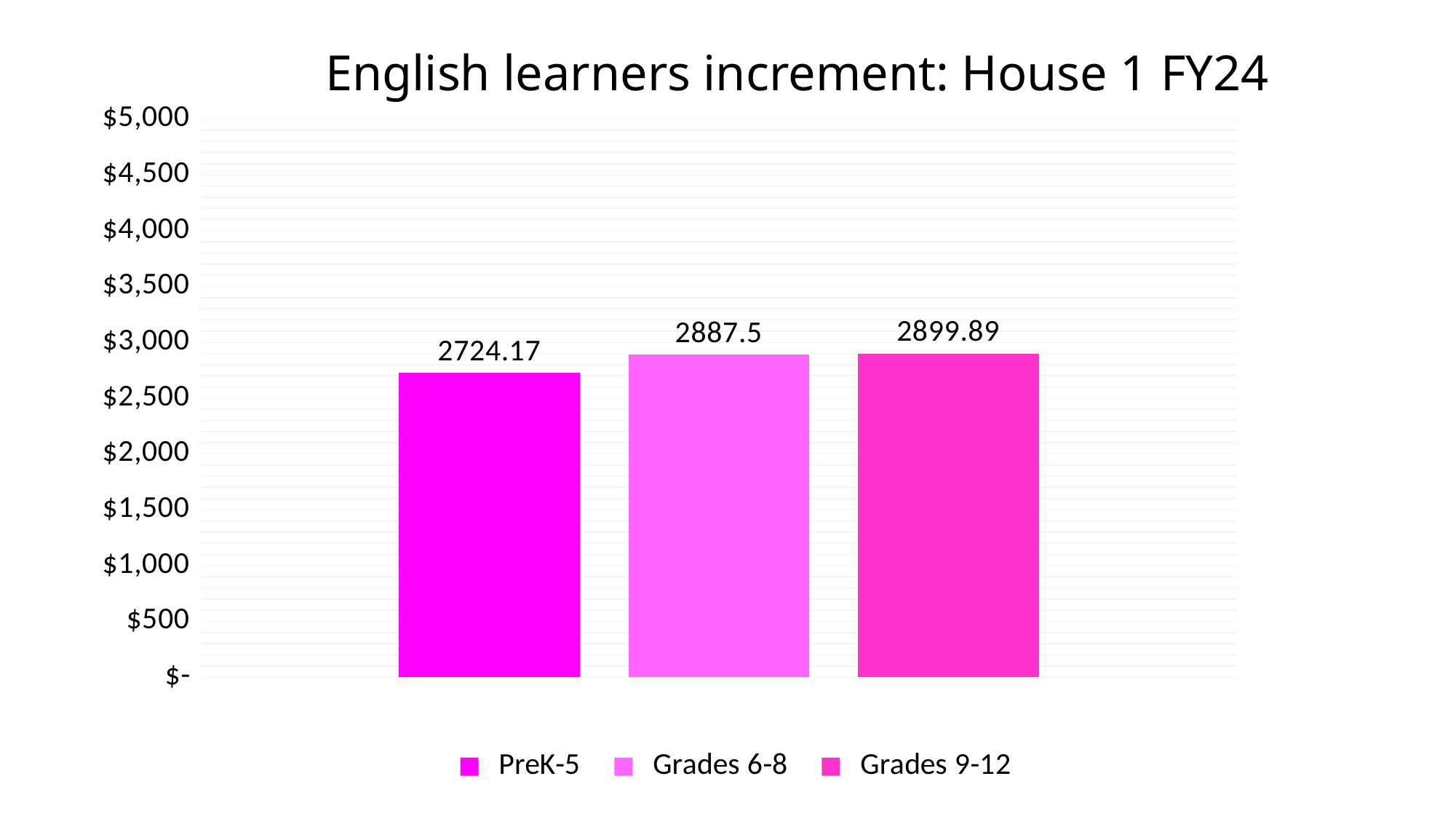
What is the difference between the values for Grades 6-8 and PreK-5? 163.33 How many bars are shown in the chart? 3 Which grade band has the lowest value? PreK-5 Which grade band has the highest value? Grades 9-12 What is the value for Grades 9-12? 2899.89 Which is larger, the value for PreK-5 or the value for Grades 6-8? Grades 6-8 What kind of chart is shown on the slide? bar chart What is the value for PreK-5? 2724.17 Is the value for PreK-5 greater or less than $3,000? less What is the value for Grades 6-8? 2887.5 What is the difference between the values for Grades 9-12 and PreK-5? 175.72 What is the title of the chart? English learners increment: House 1 FY24